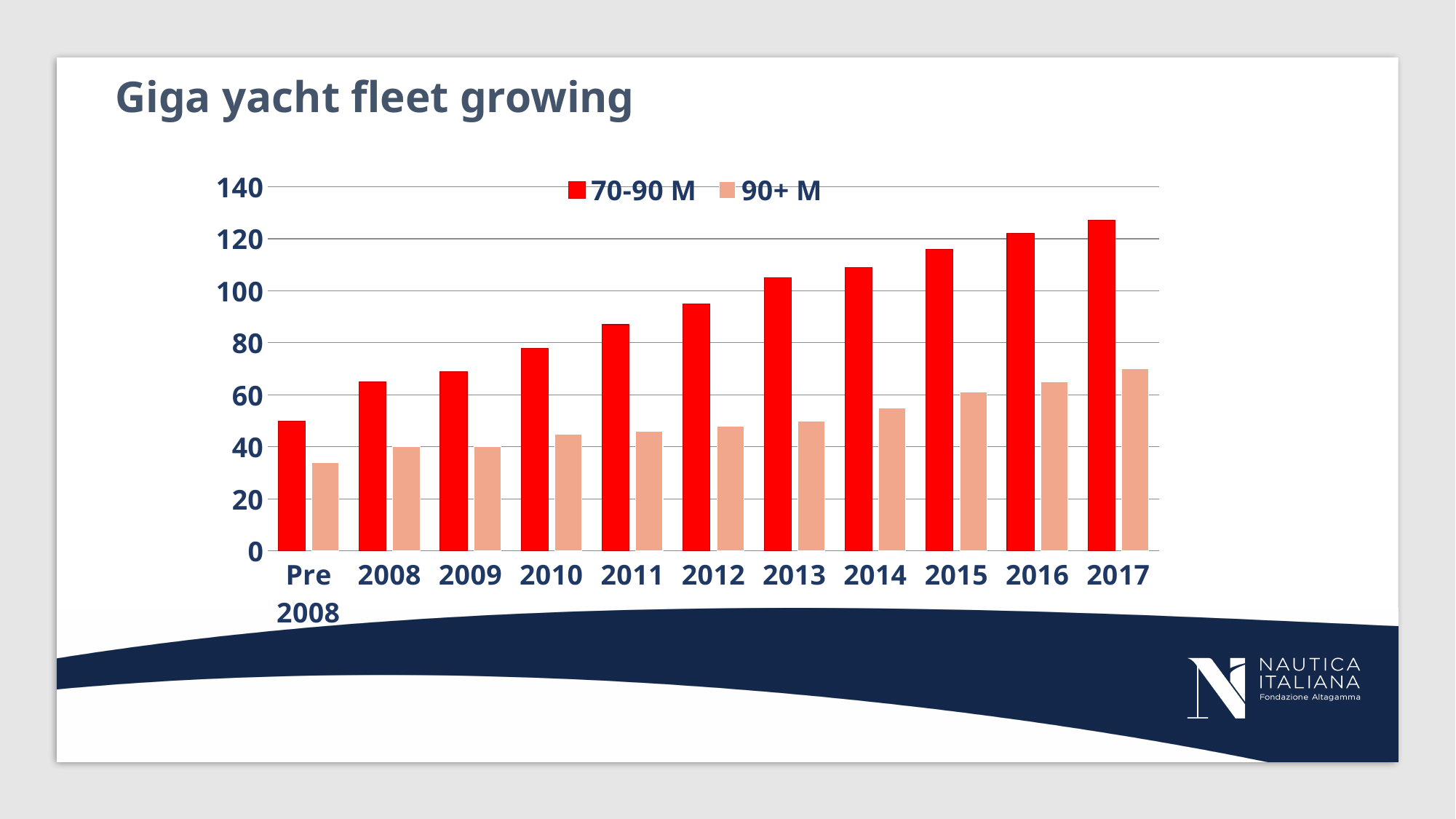
In which category is the 90+ M series lowest? Pre 2008 What kind of chart is shown on the slide? bar chart Is the value for 70-90 M in 2013 greater or less than 100? greater Does the 70-90 M series rise or fall from Pre 2008 to 2017? rise How many categories are shown along the x axis? 11 Is the value for 90+ M in Pre 2008 greater or less than 40? less In 2017, which series has the larger value, 70-90 M or 90+ M? 70-90 M What is the title of the chart? Giga yacht fleet growing In which year is the 70-90 M series highest? 2017 Is the value for 70-90 M in 2017 greater or less than 120? greater How many series does the legend list? 2